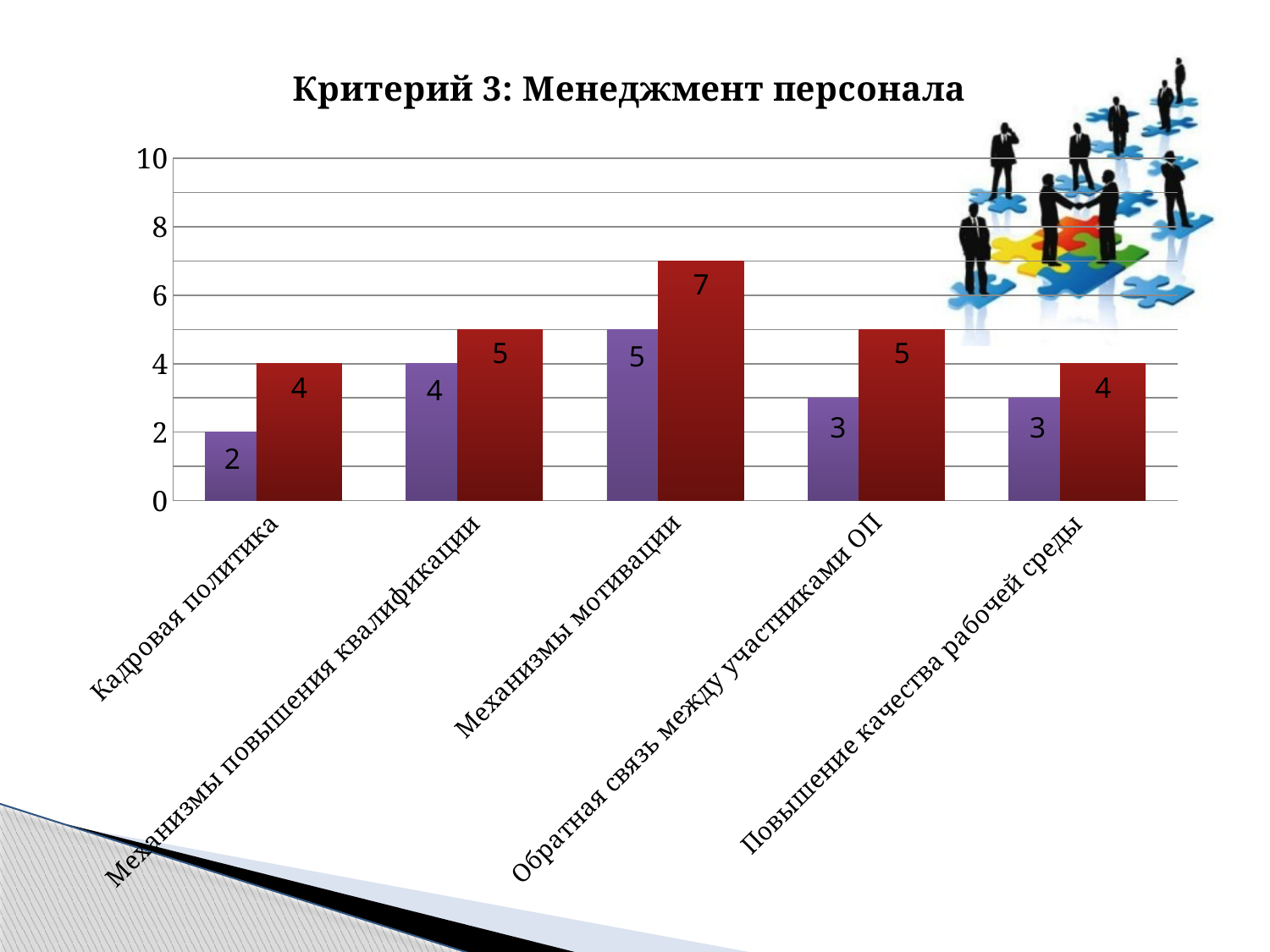
What is the value of the purple bar for Повышение качества рабочей среды? 3 What is the difference between the red and purple bars for Механизмы мотивации? 2 What is the title of the chart? Критерий 3: Менеджмент персонала Which category has the highest red bar? Механизмы мотивации What is the value of the purple bar for Кадровая политика? 2 Which category has the lowest purple bar? Кадровая политика What is the value of the red bar for Механизмы мотивации? 7 Is the red bar for Механизмы мотивации greater or less than 6? greater What is the value of the red bar for Обратная связь между участниками ОП? 5 What kind of chart is shown on the slide? bar chart How many categories are shown on the x axis? 5 Which is larger for Кадровая политика, the purple bar or the red bar? the red bar